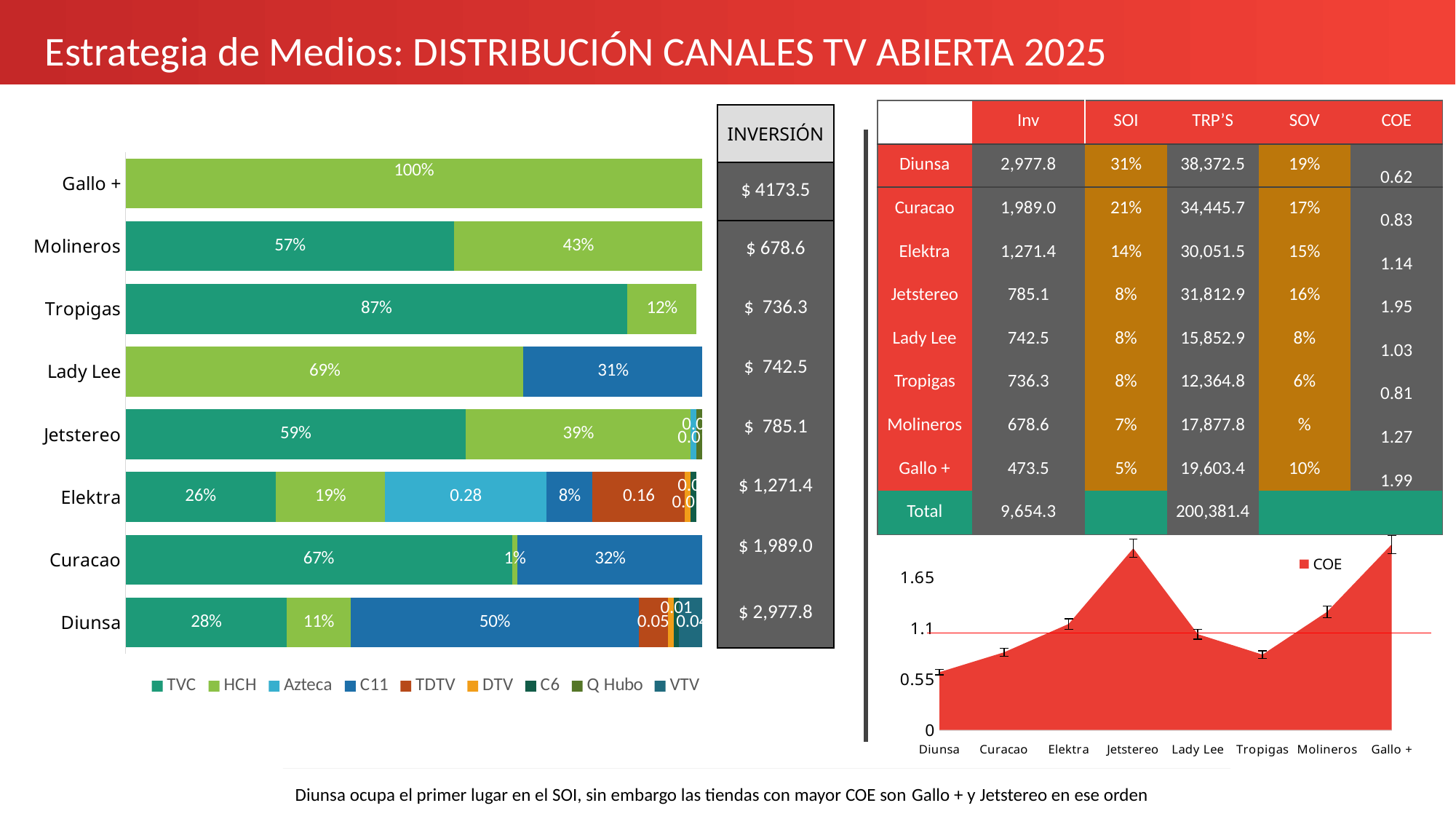
How many channels does the legend of the stacked bar chart on the left list? 9 In the stacked bar chart on the left, which store has 100% of its distribution in a single channel? Gallo + In the stacked bar chart on the left, what is the HCH share for Lady Lee? 69% In the stacked bar chart on the left, what is the C11 share for Diunsa? 50% In the stacked bar chart on the left, what is the difference between the TVC and HCH shares for Molineros? 14% In the COE chart at the bottom right, is the value for Jetstereo greater or less than 1.65? greater In the COE chart at the bottom right, which store has the highest COE? Gallo + In the COE chart at the bottom right, is the value for Diunsa greater or less than 1.1? less How many stores are shown in the stacked bar chart on the left? 8 In the stacked bar chart on the left, what percentage of Tropigas's distribution goes to TVC? 87% In the stacked bar chart on the left, which is larger for Curacao: the TVC share or the C11 share? TVC share What kind of chart is the COE chart at the bottom right? Area chart